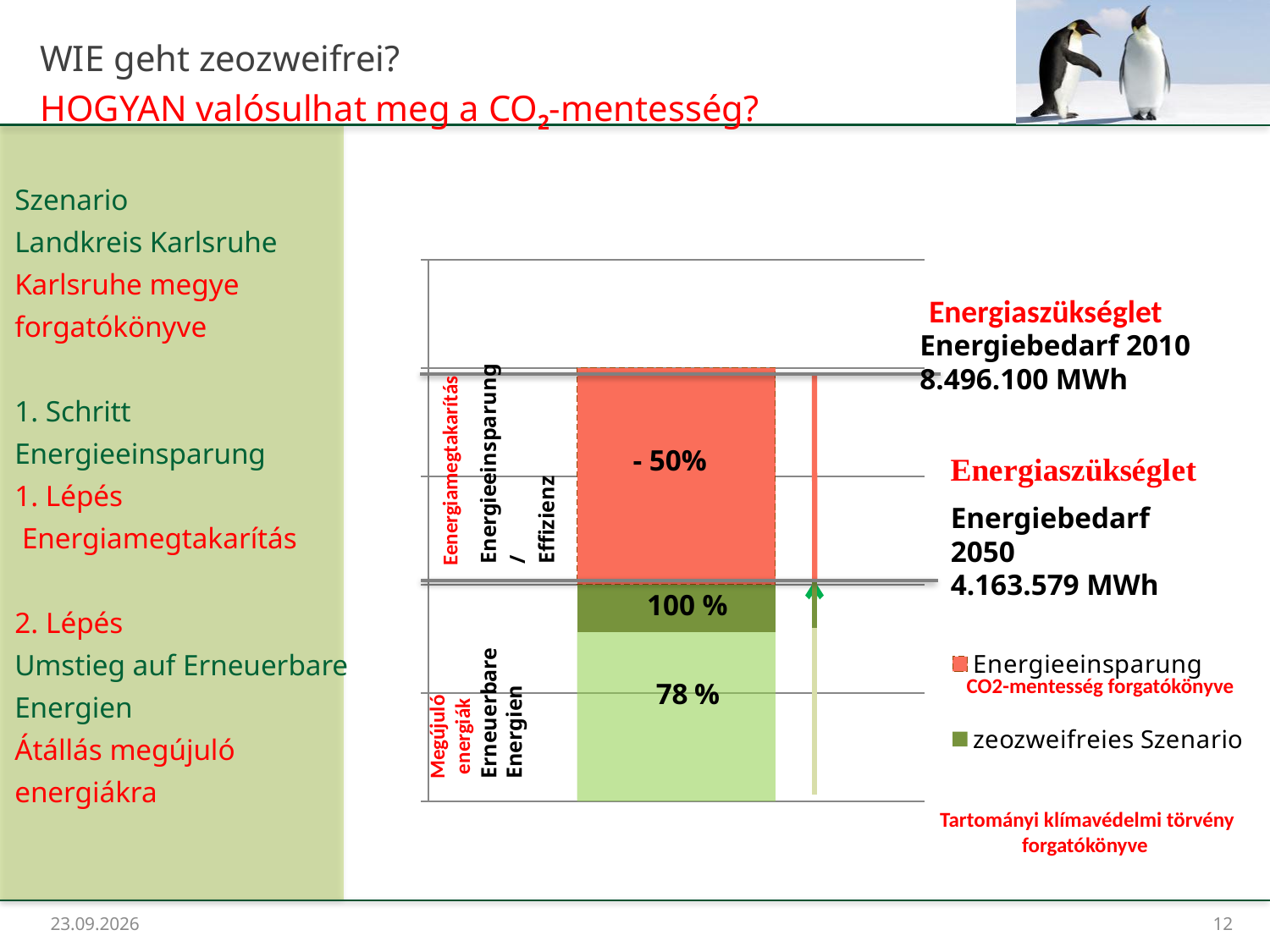
What is the difference between the Energiebedarf 2010 and the Energiebedarf 2050 values? 4.332.521 MWh What percentage label is printed on the light green segment of the bar? 78 % How many series does the chart legend list? 2 What percentage label is printed on the dark green segment of the bar? 100 % What is the Energiebedarf 2050 value shown next to the chart? 4.163.579 MWh What percentage label is printed on the red segment of the bar? - 50% What colour is the Energieeinsparung series in the legend? red Which segment of the bar is taller, the red segment or the light green segment? the red segment What are the two entries in the chart legend? Energieeinsparung, zeozweifreies Szenario Which is larger, the Energiebedarf for 2010 or for 2050? 2010 What is the Energiebedarf 2010 value shown next to the chart? 8.496.100 MWh What kind of chart is shown on the slide? bar chart